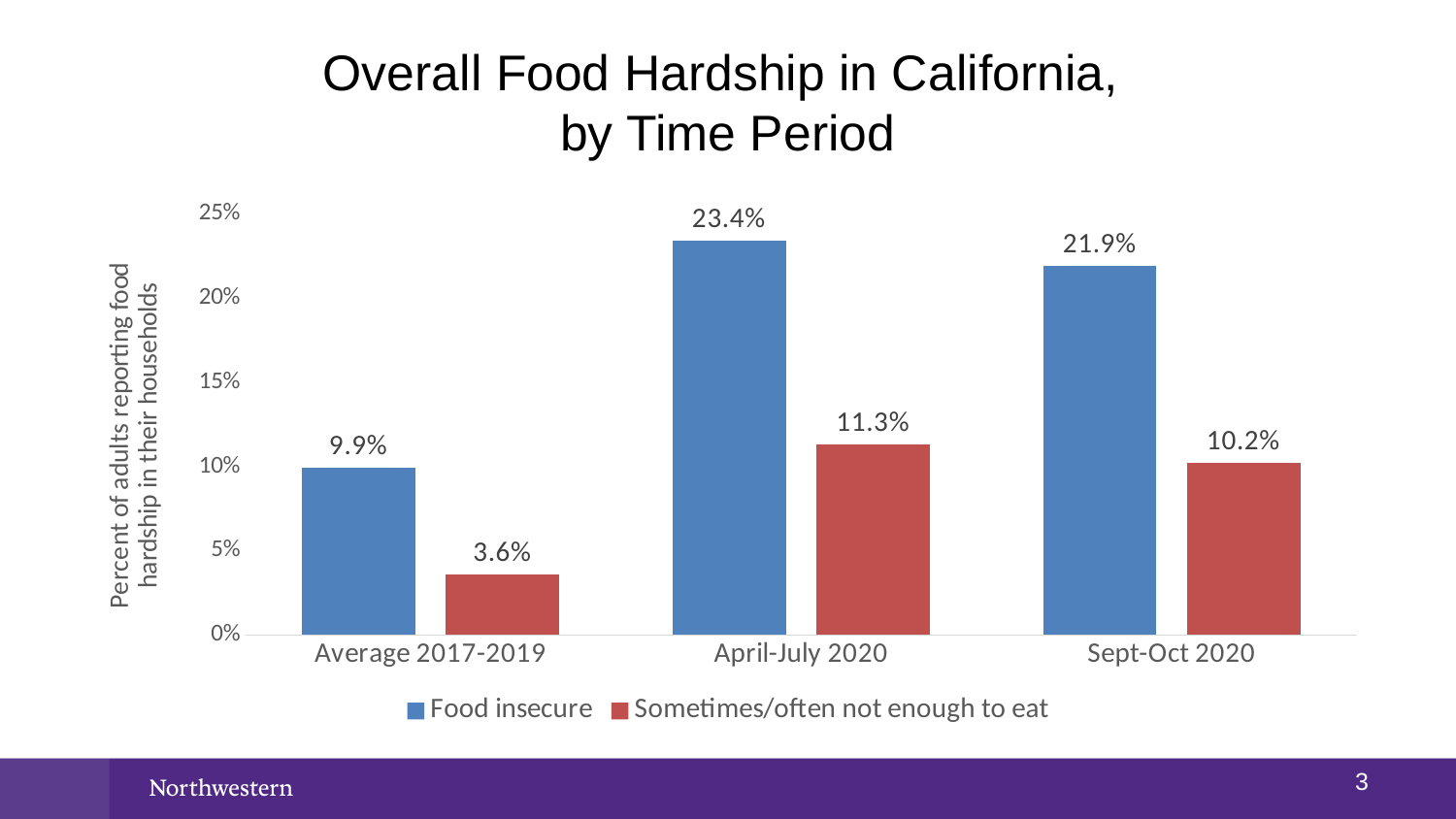
What is the value for Food insecure in April-July 2020? 23.4% What is the value for Food insecure in Sept-Oct 2020? 21.9% Which time period has the highest Food insecure value? April-July 2020 What is the title of the chart? Overall Food Hardship in California, by Time Period How many time periods are shown on the x axis? 3 What is the difference between the Food insecure values for April-July 2020 and Average 2017-2019? 13.5% How many series does the legend list? 2 Which time period has the lowest Sometimes/often not enough to eat value? Average 2017-2019 What kind of chart is shown on the slide? Bar chart What is the value for Sometimes/often not enough to eat in Average 2017-2019? 3.6% Which is larger: Sometimes/often not enough to eat in April-July 2020 or in Sept-Oct 2020? April-July 2020 Is the Food insecure value for Sept-Oct 2020 greater or less than 20%? greater